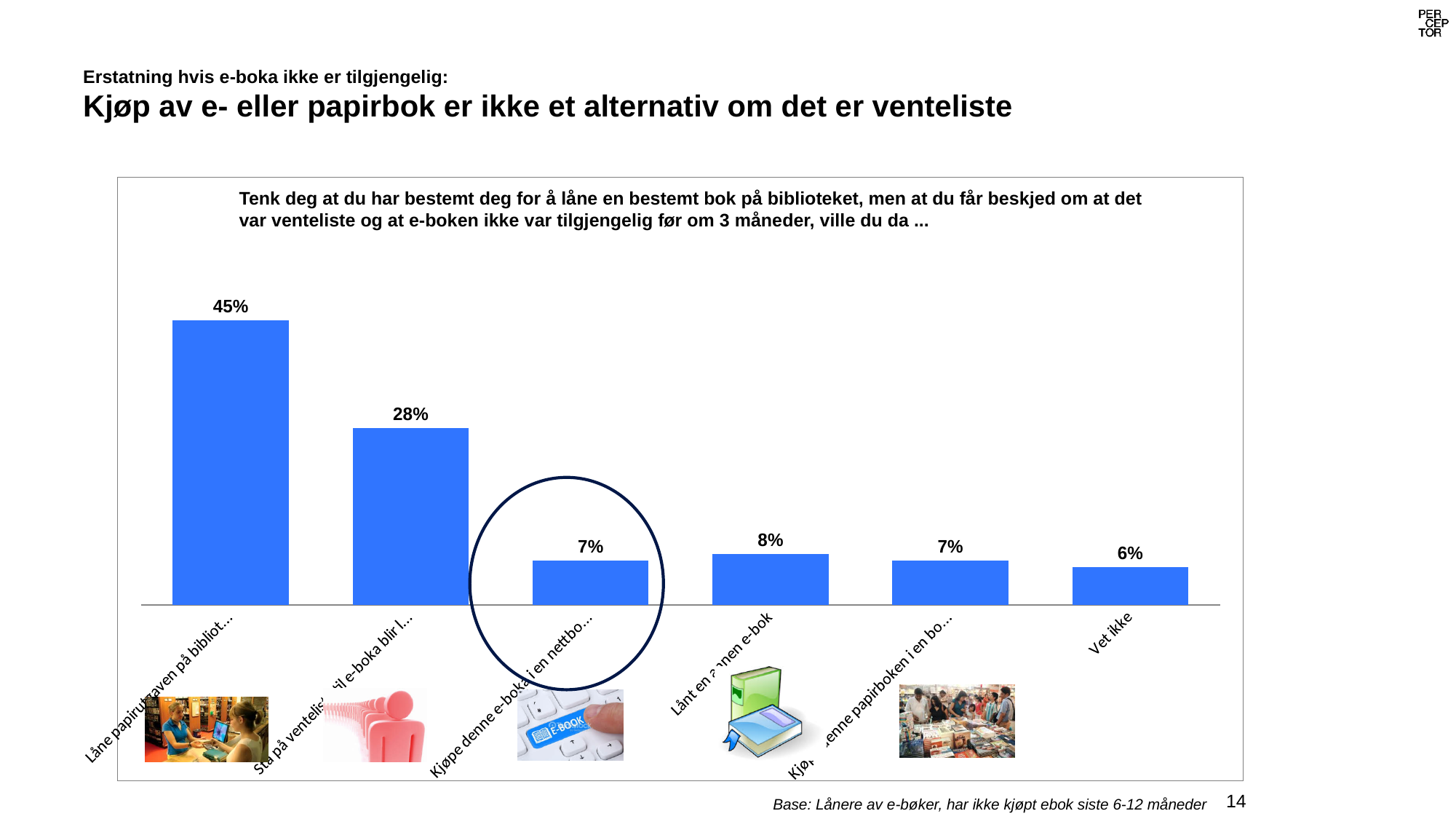
What is the value of the circled bar, 'Kjøpe denne e-boka i en nettbo...'? 7% What is the value for 'Vet ikke'? 6% What is the value of the fourth bar from the left? 8% What kind of chart is shown on the slide? bar chart What is the total of the first two bars (45% and 28%)? 73% Which category has the highest value? Låne papirutgaven på bibliot... Which category has the lowest value? Vet ikke What is the value of the second bar, 'Stå på venteliste til e-boka blir l...'? 28% What is the difference between the first bar (45%) and the second bar (28%)? 17 percentage points Which is larger: the value for 'Vet ikke' or the value of the fourth bar from the left? the fourth bar (8%) What is the value of the first (leftmost) bar, 'Låne papirutgaven på bibliot...'? 45% How many bars does the chart have? 6